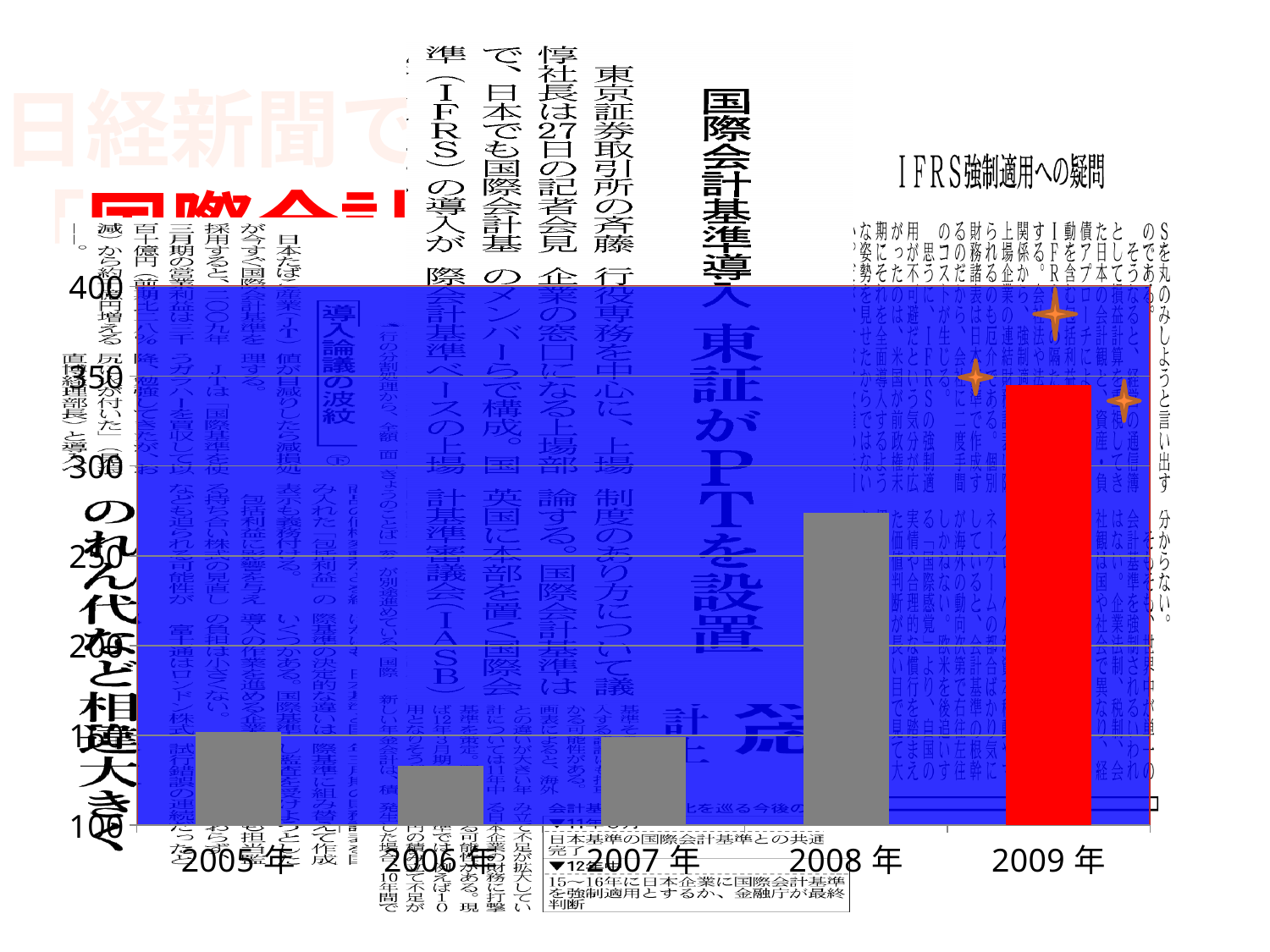
Which is larger, the value for 2009 年 or the value for 2008 年? 2009 年 Which year has the lowest bar in the chart? 2006 年 How many years are shown on the x axis of the chart? 5 What kind of chart is shown on the slide? bar chart From 2007 年 to 2009 年, do the bar values rise or fall? rise Is the value for 2008 年 greater or less than 300? less Which year has the highest bar in the chart? 2009 年 Which is larger, the value for 2008 年 or the value for 2007 年? 2008 年 Is the value for 2006 年 greater or less than 150? less Is the value for 2008 年 greater or less than 250? greater What colour is the bar for 2009 年? red